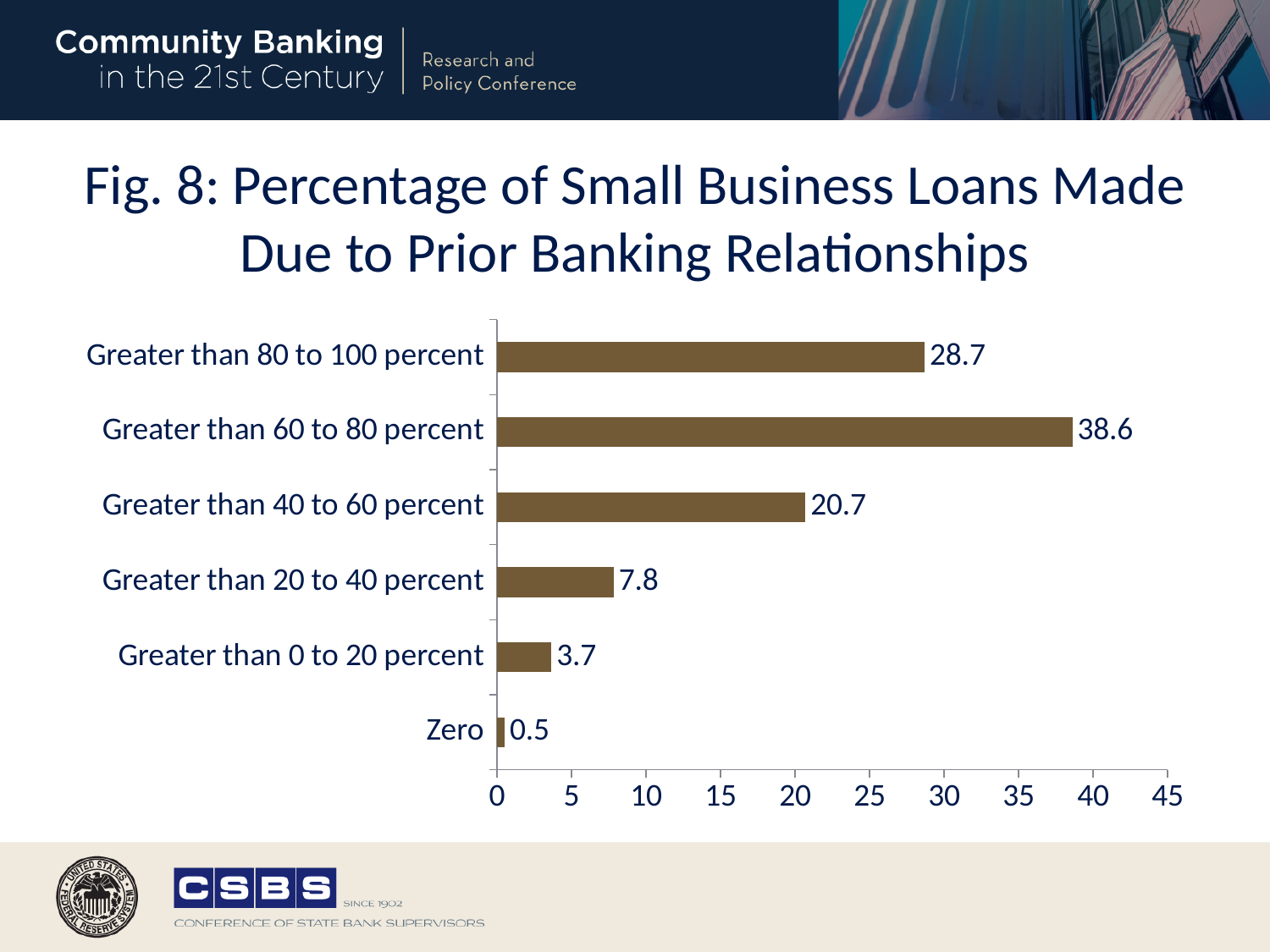
What is the title of the chart? Fig. 8: Percentage of Small Business Loans Made Due to Prior Banking Relationships Which category has the highest value? Greater than 60 to 80 percent How many categories are shown in the chart? 6 Which is larger: the value for 'Greater than 40 to 60 percent' or 'Greater than 80 to 100 percent'? Greater than 80 to 100 percent What is the difference between the values for 'Greater than 60 to 80 percent' and 'Greater than 80 to 100 percent'? 9.9 What is the value for the 'Greater than 60 to 80 percent' category? 38.6 What is the difference between the values for 'Greater than 0 to 20 percent' and 'Zero'? 3.2 Which category has the lowest value? Zero What kind of chart is shown on the slide? Bar chart What is the value for the 'Zero' category? 0.5 What is the value for the 'Greater than 20 to 40 percent' category? 7.8 Is the value for 'Greater than 40 to 60 percent' greater or less than 25? less